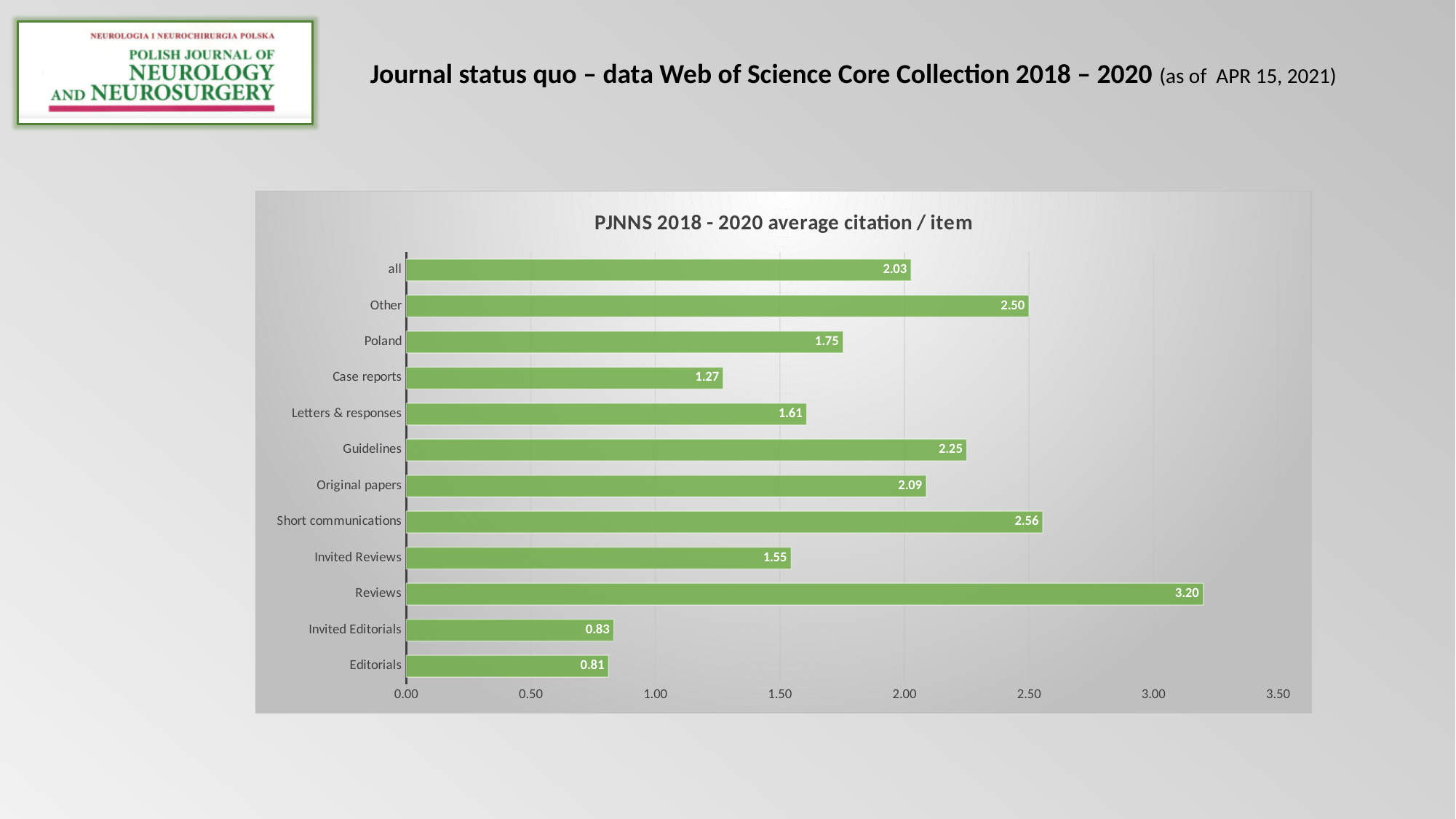
What is the title of the chart? PJNNS 2018 - 2020 average citation / item Which has a higher average citation per item, Guidelines or Original papers? Guidelines What is the value shown for Poland? 1.75 What is the average citation per item for Case reports? 1.27 What kind of chart is shown on the slide? Bar chart What is the average citation per item for Reviews? 3.20 How many categories are shown in the chart? 12 What is the difference between the values for Invited Editorials and Editorials? 0.02 Which category has the highest average citation per item? Reviews What is the difference between the values for Short communications and Invited Reviews? 1.01 Which category has the lowest average citation per item? Editorials Is the value for Other greater or less than 2.00? greater